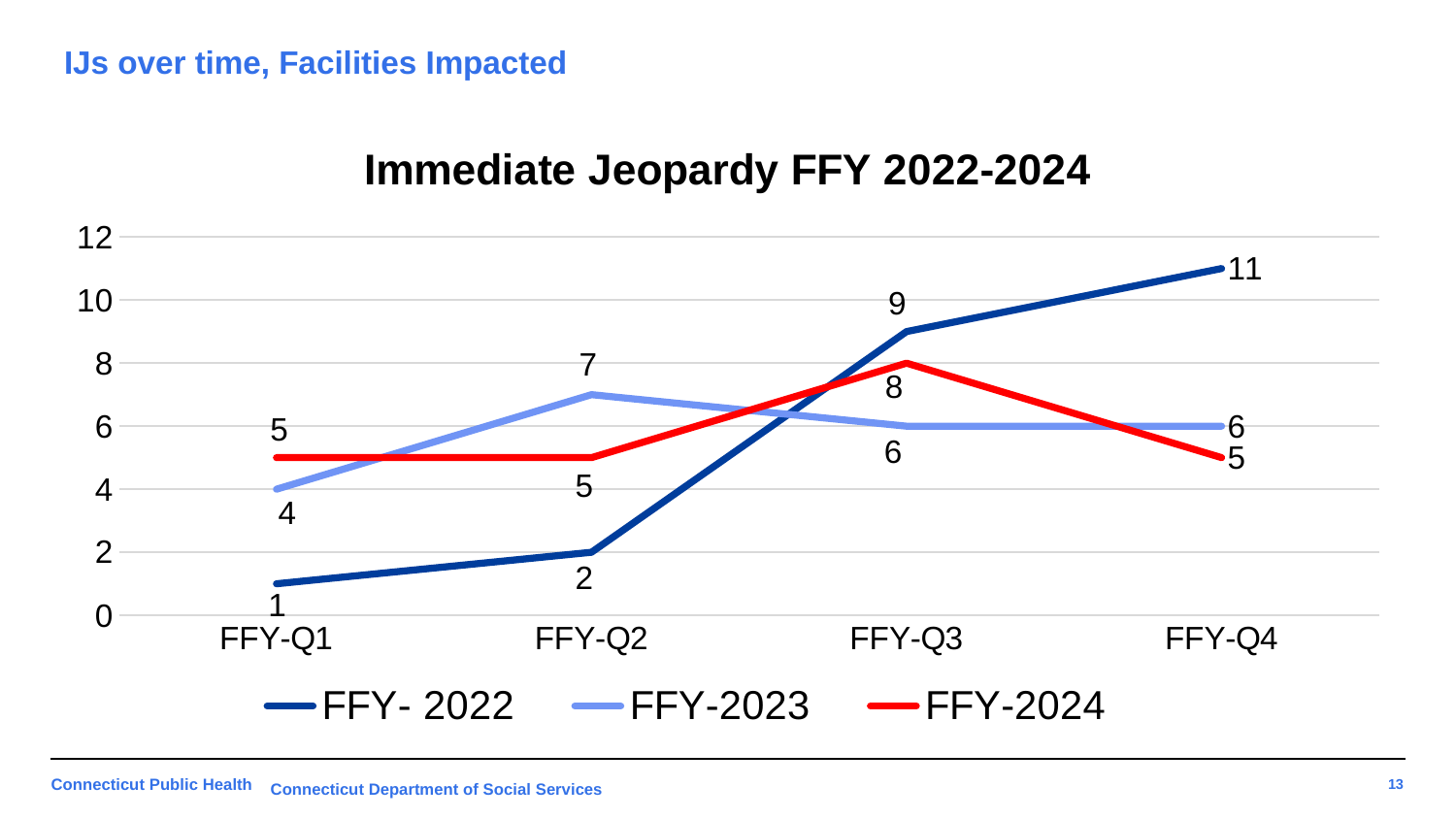
What is the title of the chart? Immediate Jeopardy FFY 2022-2024 What is the value for FFY- 2022 at FFY-Q4? 11 What is the difference between the FFY- 2022 and FFY-2024 values at FFY-Q4? 6 In which quarter does the FFY- 2022 series reach its highest value? FFY-Q4 What is the value for FFY-2024 at FFY-Q3? 8 What is the value for FFY-2023 at FFY-Q2? 7 What type of chart is shown on the slide? Line chart Does the FFY- 2022 series rise or fall from FFY-Q1 to FFY-Q4? Rise How many series does the legend list? 3 At FFY-Q1, which series has the larger value, FFY-2023 or FFY-2024? FFY-2024 In which quarter does the FFY- 2022 series have its lowest value? FFY-Q1 How many quarters are plotted along the x axis? 4